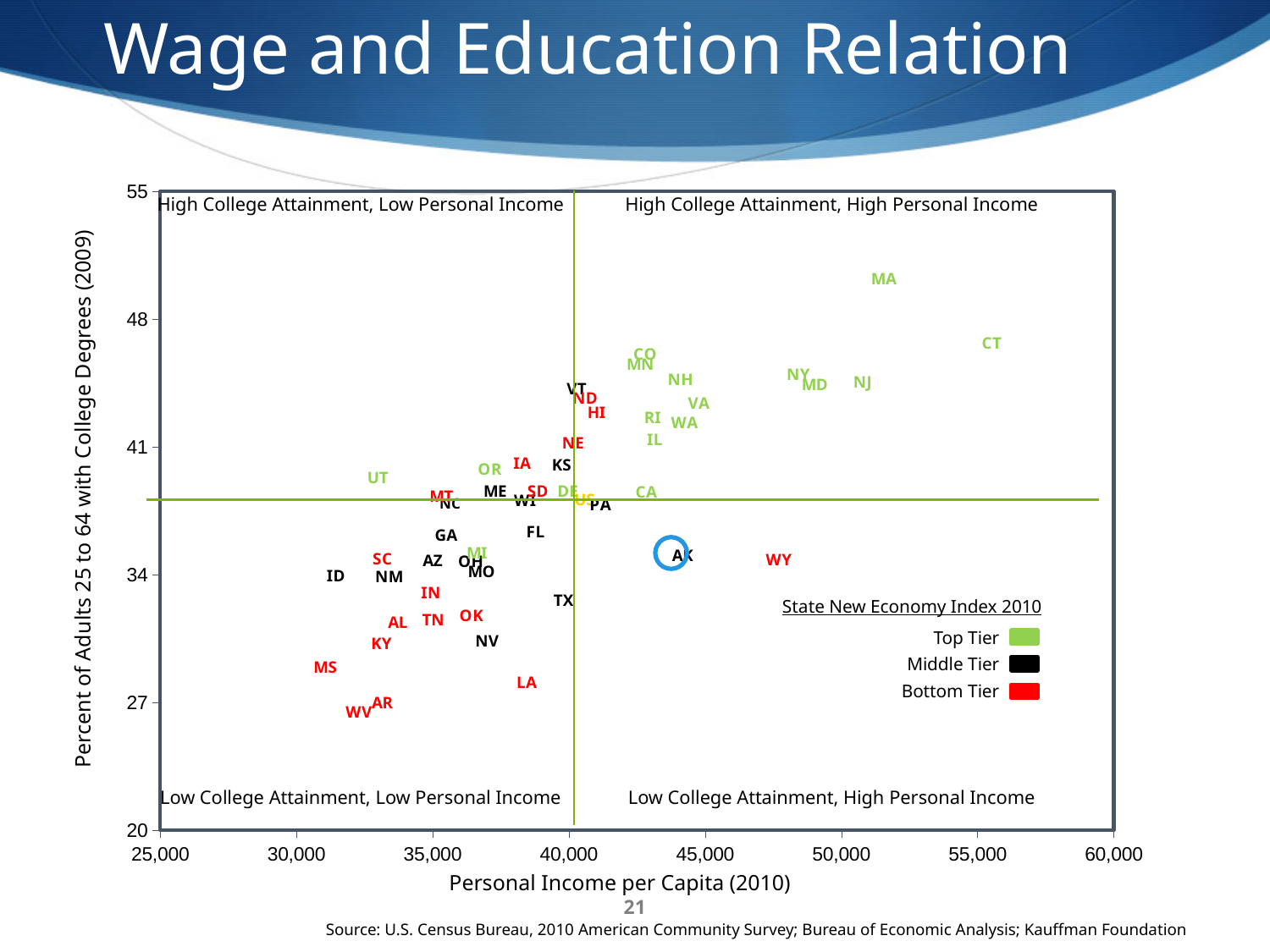
Is the percent of adults with college degrees for MA greater or less than 48? greater Is the personal income per capita for WY greater or less than 45,000? greater Is the personal income per capita for ID greater or less than 35,000? less Which state has the highest percent of adults with college degrees? MA How many tiers does the legend list? 3 Which state has the lowest personal income per capita? MS Which state is highlighted with a blue circle? AK Which has a higher personal income per capita, WY or AK? WY Which has a higher percent of adults with college degrees, MA or CT? MA What kind of chart is shown on the slide? Scatter plot Which state has the highest personal income per capita? CT